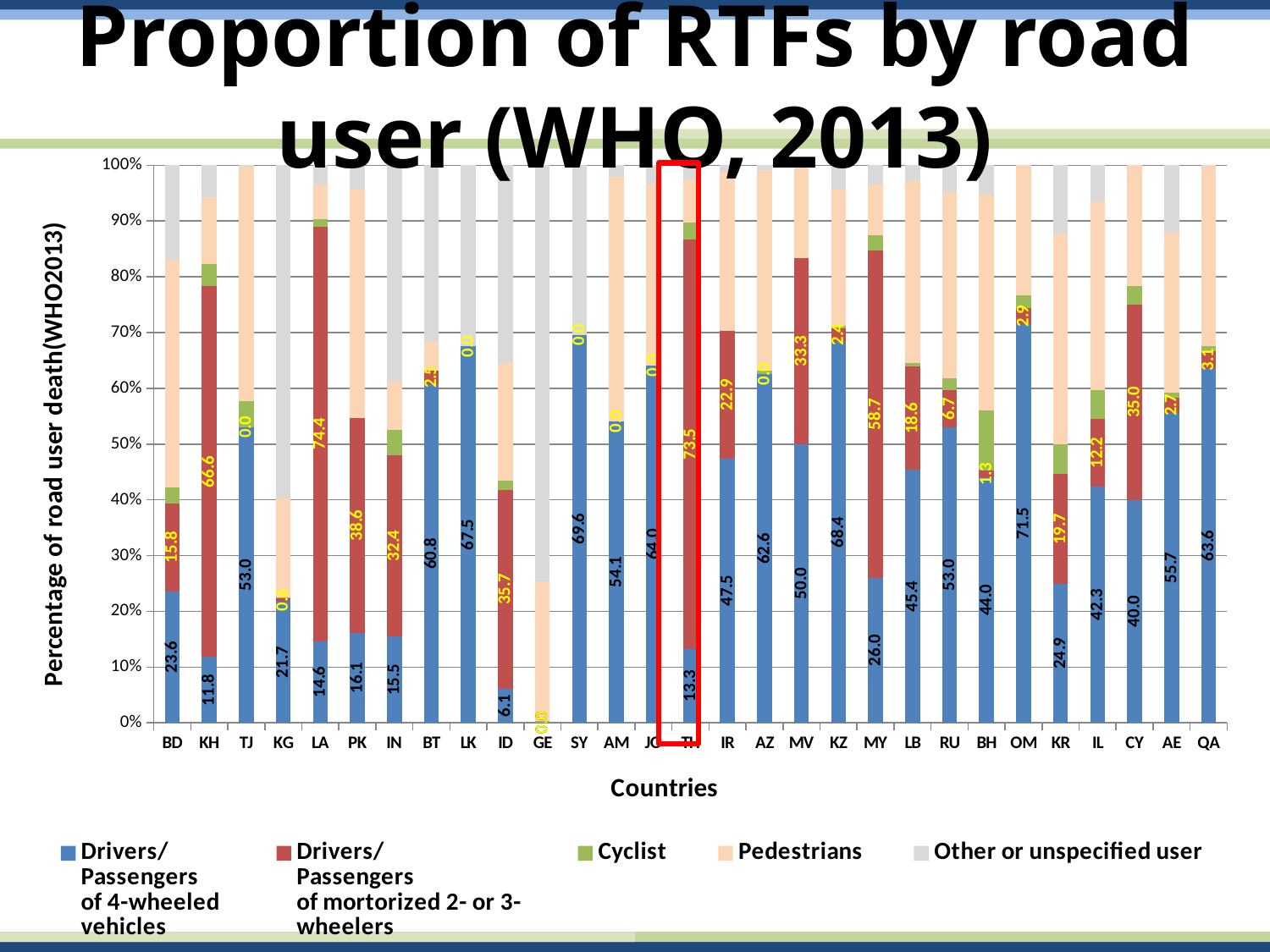
How many countries are shown on the x axis? 29 Which country has the highest value for Drivers/Passengers of 4-wheeled vehicles? OM Which has the larger value for Drivers/Passengers of motorized 2- or 3-wheelers, TH or MY? TH What kind of chart is shown on the slide? Stacked bar chart What is the value for Drivers/Passengers of 4-wheeled vehicles for TH? 13.3 What is the title of the x axis? Countries How many series does the legend list? 5 What is the value for Drivers/Passengers of motorized 2- or 3-wheelers for MV? 33.3 What is the value for Drivers/Passengers of 4-wheeled vehicles for OM? 71.5 What is the difference between the Drivers/Passengers of 4-wheeled vehicles values for LK and BD? 43.9 Which country has the highest value for Drivers/Passengers of motorized 2- or 3-wheelers? LA What is the value for Drivers/Passengers of motorized 2- or 3-wheelers for KH? 66.6